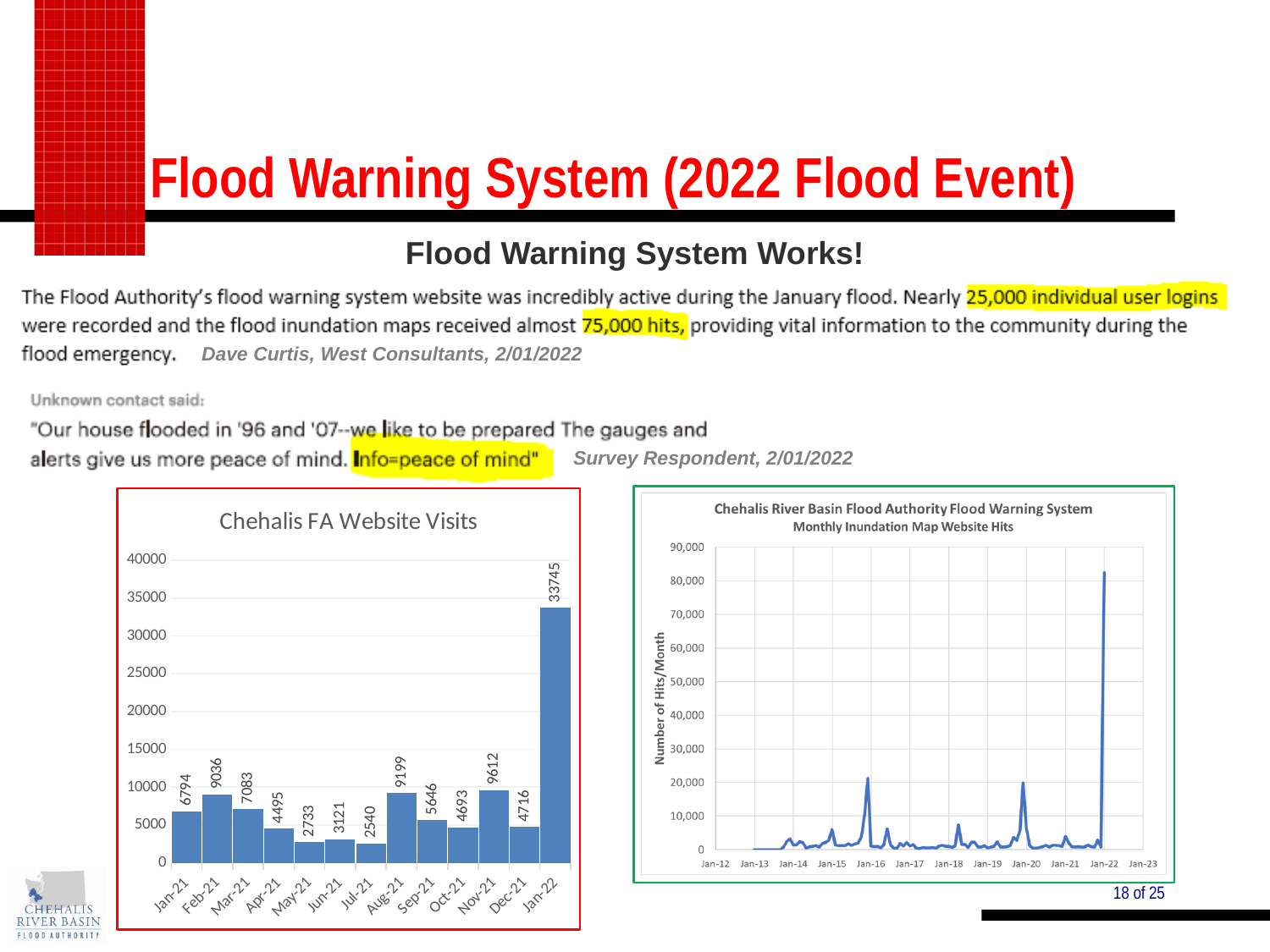
In the Chehalis FA Website Visits chart, what is the value for May-21? 2733 In the Chehalis FA Website Visits chart, what is the value for Jan-22? 33745 In the Monthly Inundation Map Website Hits chart, is the peak value near Jan-22 greater or less than 80,000? greater In the Chehalis FA Website Visits chart, which month has the lowest value? Jul-21 In the Chehalis FA Website Visits chart, which month has the highest value? Jan-22 What is the y-axis label of the Monthly Inundation Map Website Hits chart? Number of Hits/Month In the Chehalis FA Website Visits chart, what is the difference between Nov-21 and Dec-21? 4896 What kind of chart is the Chehalis FA Website Visits chart? Bar chart In the Chehalis FA Website Visits chart, what is the value for Aug-21? 9199 In the Chehalis FA Website Visits chart, which is larger, Feb-21 or Mar-21? Feb-21 How many months are shown in the Chehalis FA Website Visits chart? 13 What kind of chart is the Monthly Inundation Map Website Hits chart on the right? Line chart